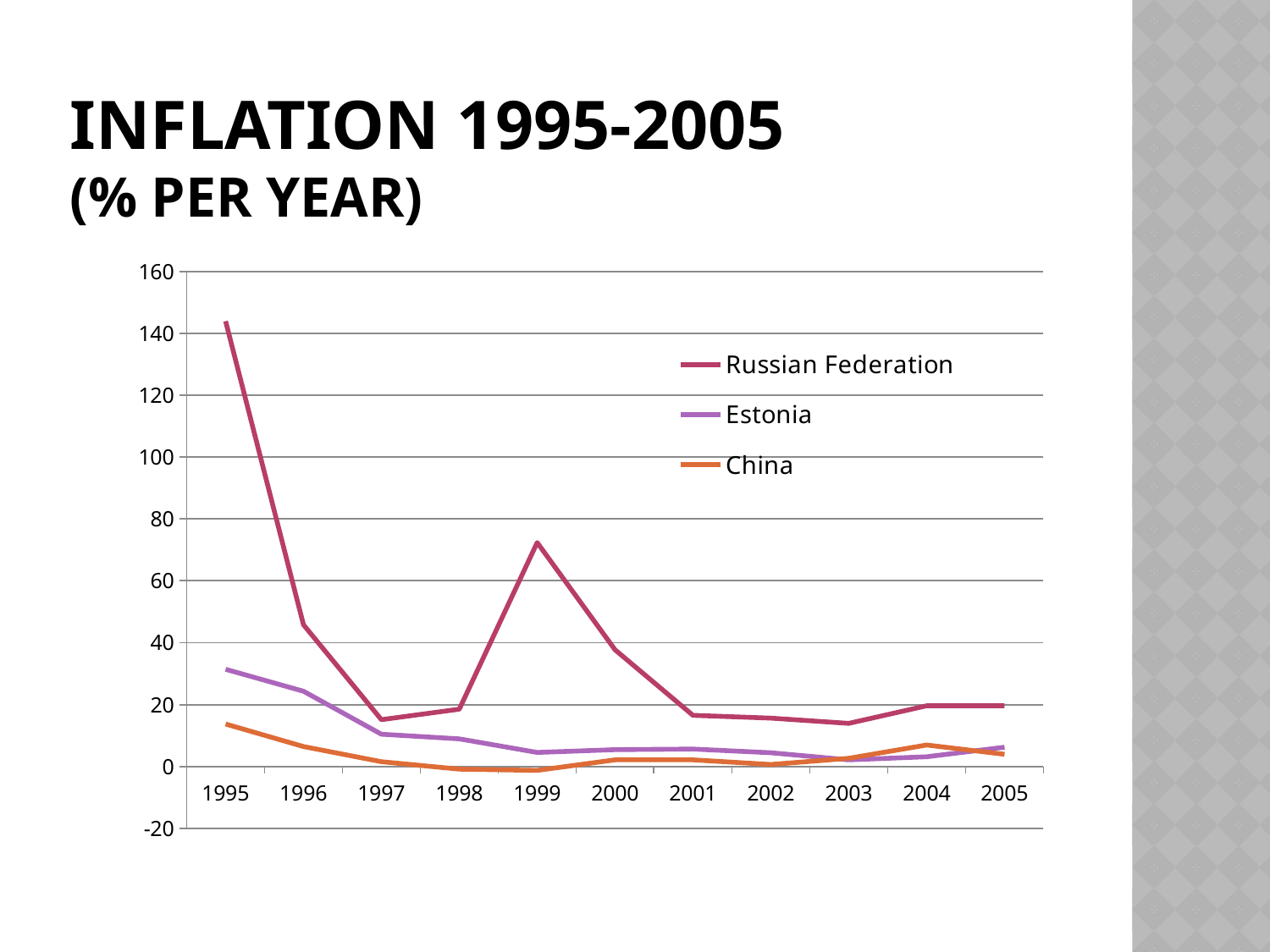
How many years are shown along the x axis? 11 Which series is drawn in orange? China Does Estonia's inflation generally rise or fall from 1995 to 2003? fall Which series has the higher value in 1995, Russian Federation or Estonia? Russian Federation Is the value for the Russian Federation in 1995 greater or less than 120? greater What kind of chart is shown on the slide? line chart In which year is the Russian Federation's inflation highest? 1995 Is the value for the Russian Federation in 1999 greater or less than 60? greater Is the value for China in 1995 greater or less than 20? less Which series has the lower value in 1997, Estonia or China? China How many series does the legend list? 3